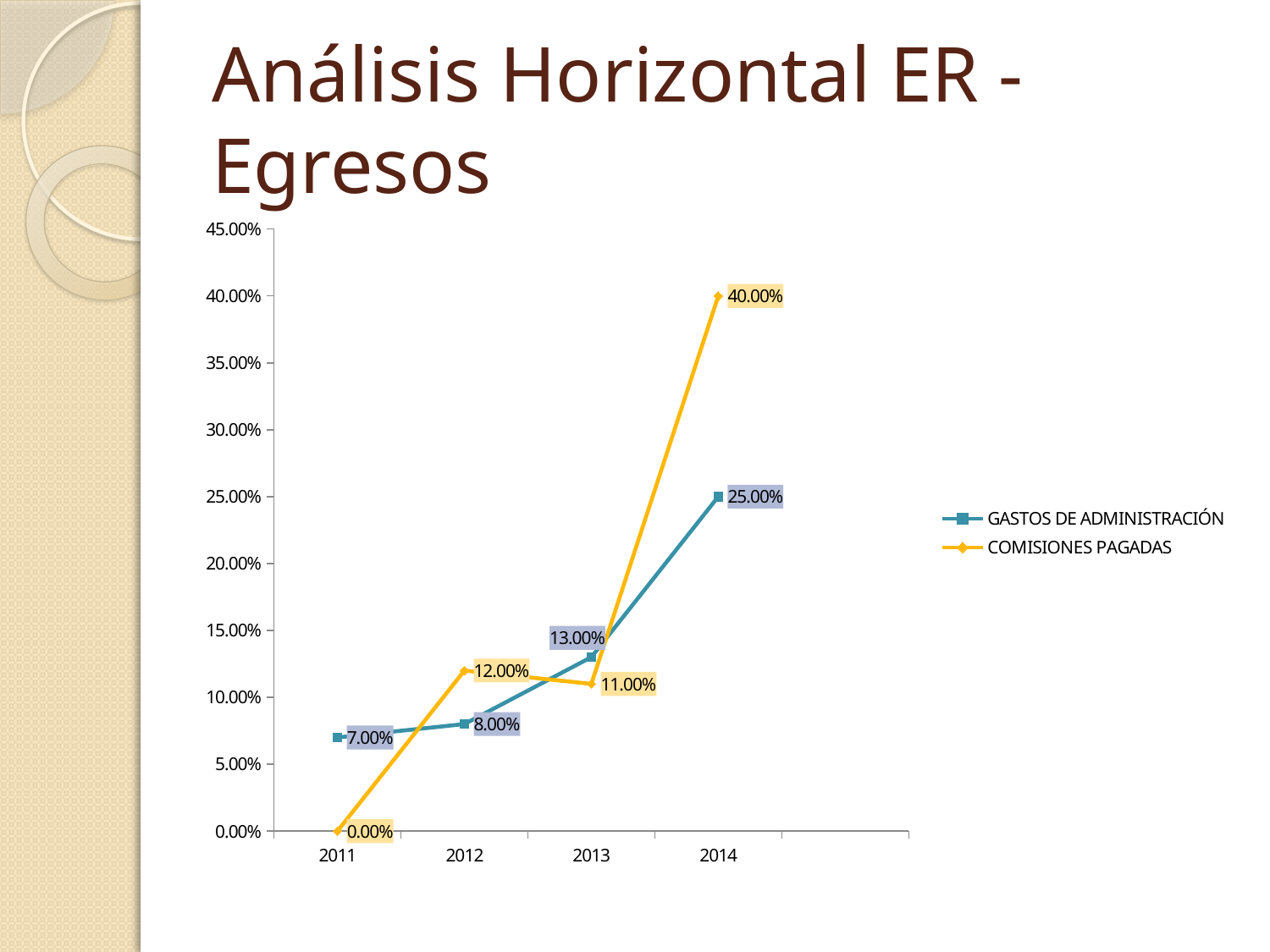
What is the difference between COMISIONES PAGADAS and GASTOS DE ADMINISTRACIÓN in 2014? 15.00% What is the value for GASTOS DE ADMINISTRACIÓN in 2013? 13.00% What is the value for COMISIONES PAGADAS in 2012? 12.00% In which year is GASTOS DE ADMINISTRACIÓN lowest? 2011 How many years are shown on the x axis? 4 How many series does the legend list? 2 Does GASTOS DE ADMINISTRACIÓN rise or fall from 2011 to 2014? Rise What kind of chart is shown on the slide? Line chart What is the value for COMISIONES PAGADAS in 2011? 0.00% In which year is COMISIONES PAGADAS highest? 2014 What is the value for GASTOS DE ADMINISTRACIÓN in 2014? 25.00% Which series has the larger value in 2013, GASTOS DE ADMINISTRACIÓN or COMISIONES PAGADAS? GASTOS DE ADMINISTRACIÓN